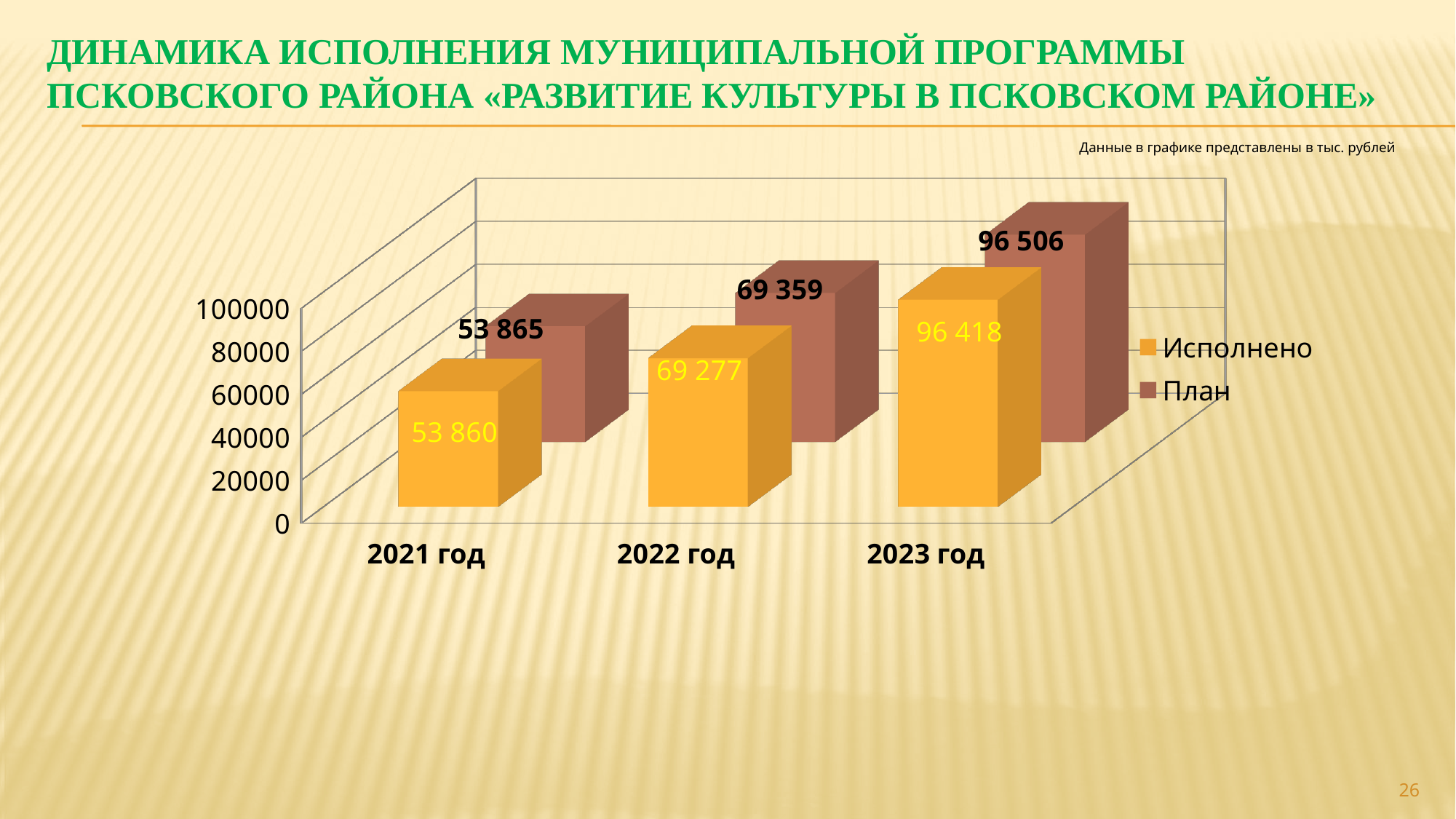
How many series does the legend list? 2 How many years are shown on the x axis? 3 What is the План value for 2021 год? 53 865 What kind of chart is shown on the slide? Bar chart Which is larger: the Исполнено value for 2022 год or the Исполнено value for 2021 год? 2022 год Which year has the lowest План value? 2021 год By how much did the Исполнено value increase from 2021 год to 2023 год? 42 558 What is the difference between the План and Исполнено values for 2023 год? 88 Which year has the highest Исполнено value? 2023 год What is the План value for 2023 год? 96 506 Do the Исполнено values rise or fall from 2021 год to 2023 год? Rise What is the Исполнено value for 2022 год? 69 277